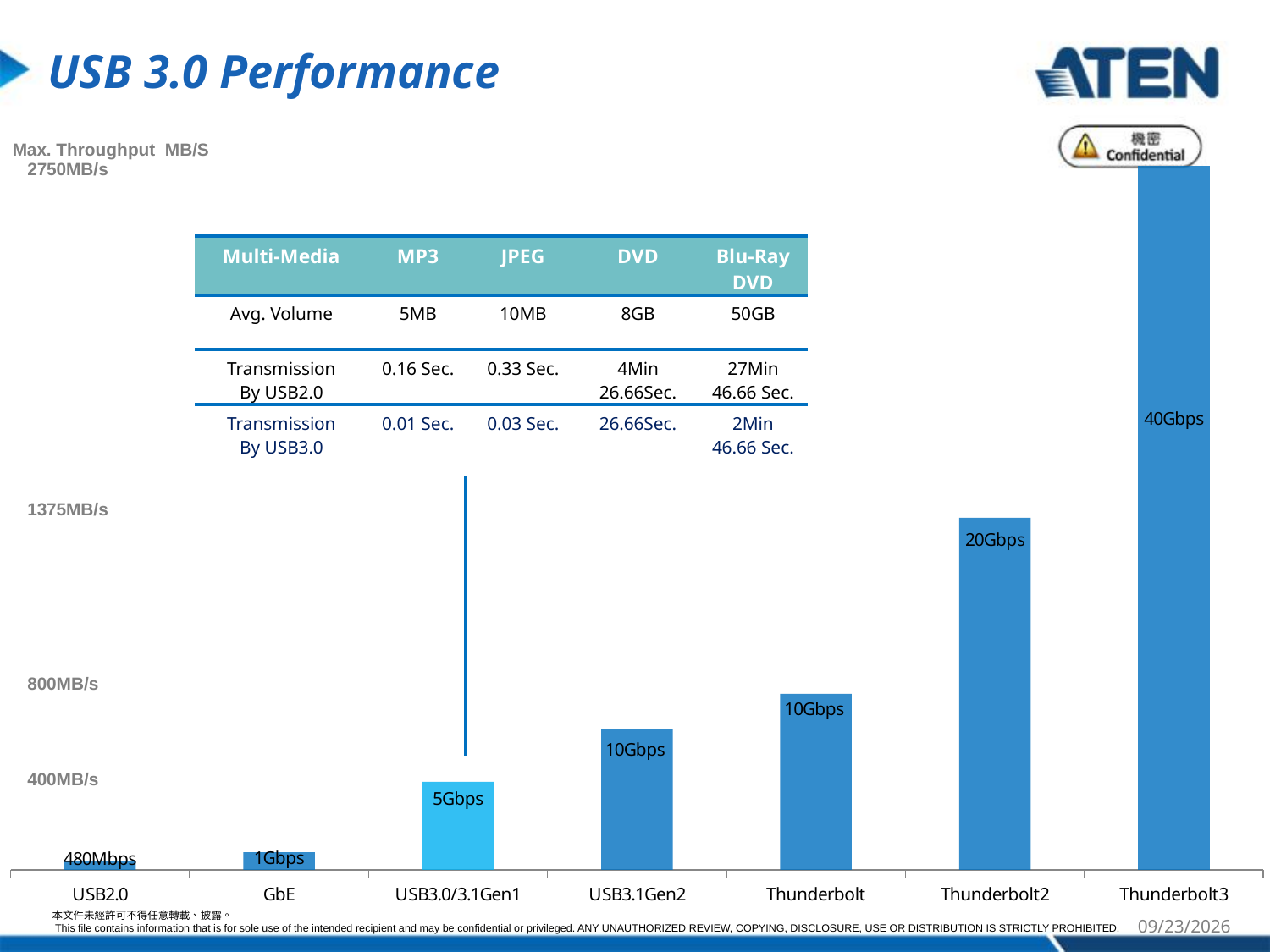
What kind of chart is shown on the slide? bar chart Which bar is taller, Thunderbolt2 or USB3.1Gen2? Thunderbolt2 What is the data label on the bar for Thunderbolt2? 20Gbps Which category has the tallest bar? Thunderbolt3 What is the data label on the bar for GbE? 1Gbps What is the data label on the bar for USB2.0? 480Mbps Do the bar values generally rise or fall from left to right along the x axis? rise What is the label of the vertical axis of the chart? Max. Throughput MB/S What is the data label on the bar for Thunderbolt3? 40Gbps What is the data label on the bar for USB3.0/3.1Gen1? 5Gbps Which category has the shortest bar? USB2.0 How many categories are shown on the x axis of the chart? 7